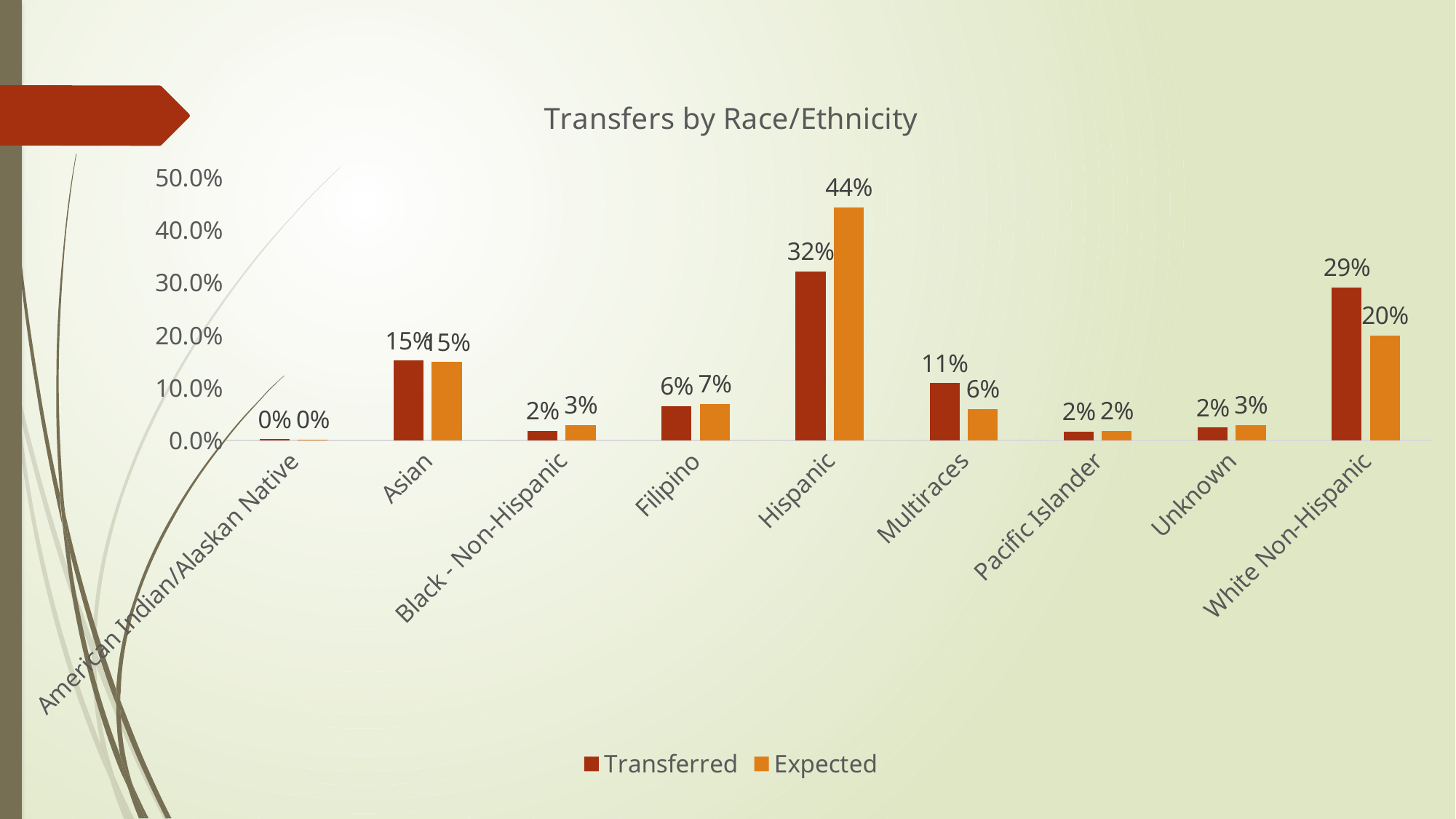
Which category has the lowest Transferred value? American Indian/Alaskan Native What kind of chart is shown on the slide? Bar chart What is the Expected value for Multiraces? 6% What is the difference between the Expected and Transferred values for Hispanic? 12% What is the Transferred value for Hispanic? 32% For White Non-Hispanic, which is larger: Transferred or Expected? Transferred Is the Expected value for Hispanic greater or less than 40.0%? greater How many race/ethnicity categories are shown on the x axis? 9 What is the title of the chart? Transfers by Race/Ethnicity What is the Expected value for White Non-Hispanic? 20% Which category has the highest Expected value? Hispanic How many series does the legend list? 2